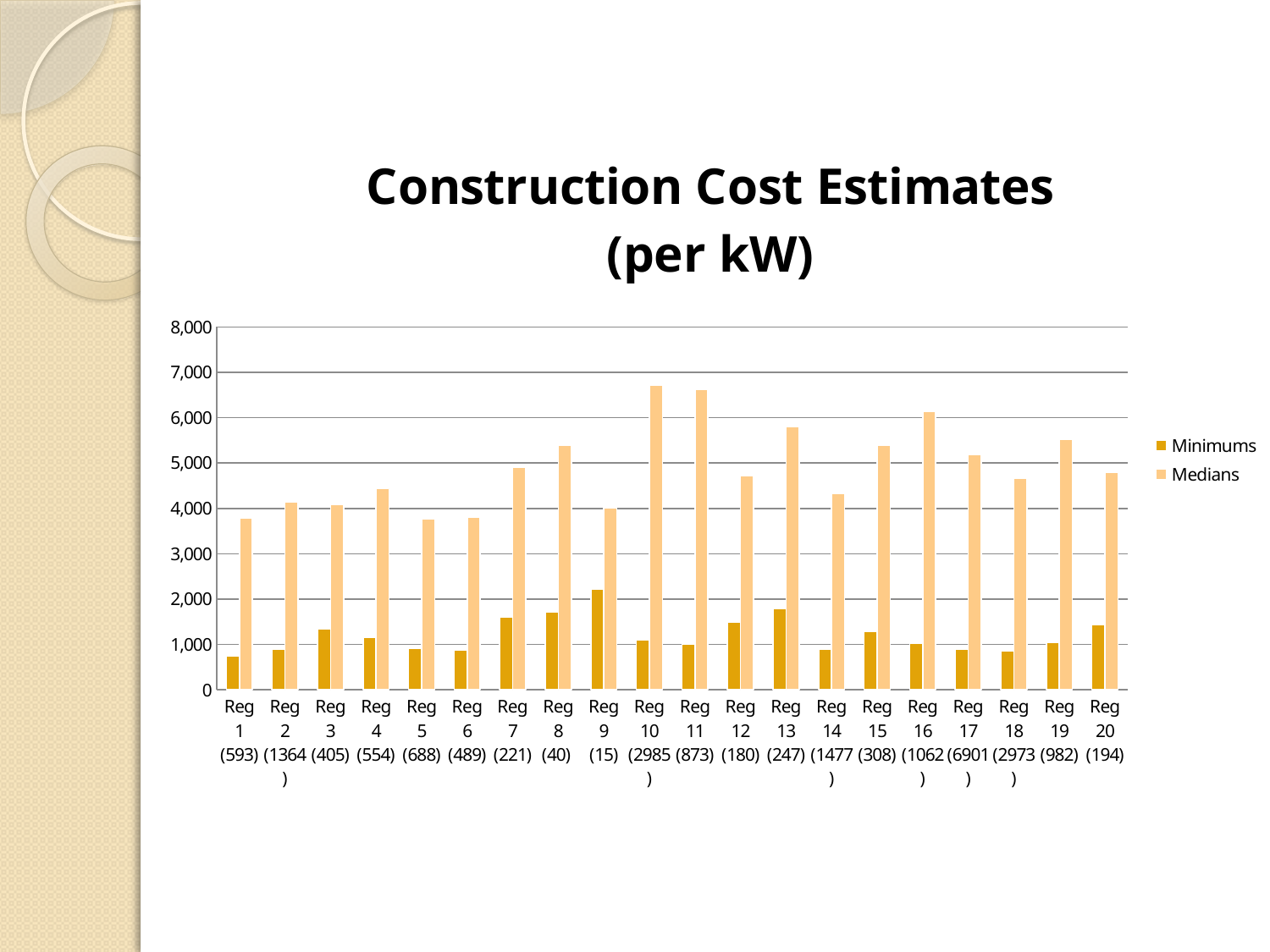
Which is larger, the Medians value for Reg 10 or the Medians value for Reg 1? Reg 10 How many series does the legend list? 2 Is the Medians value for Reg 10 greater or less than 6,000? greater Is the Minimums value for Reg 1 greater or less than 1,000? less Which region has the highest Minimums value? Reg 9 Is the Medians value for Reg 5 greater or less than 4,000? less What kind of chart is shown on the slide? bar chart Which is larger, the Minimums value for Reg 9 or the Minimums value for Reg 2? Reg 9 What are the two series named in the legend? Minimums and Medians How many regions (categories) are plotted on the x axis? 20